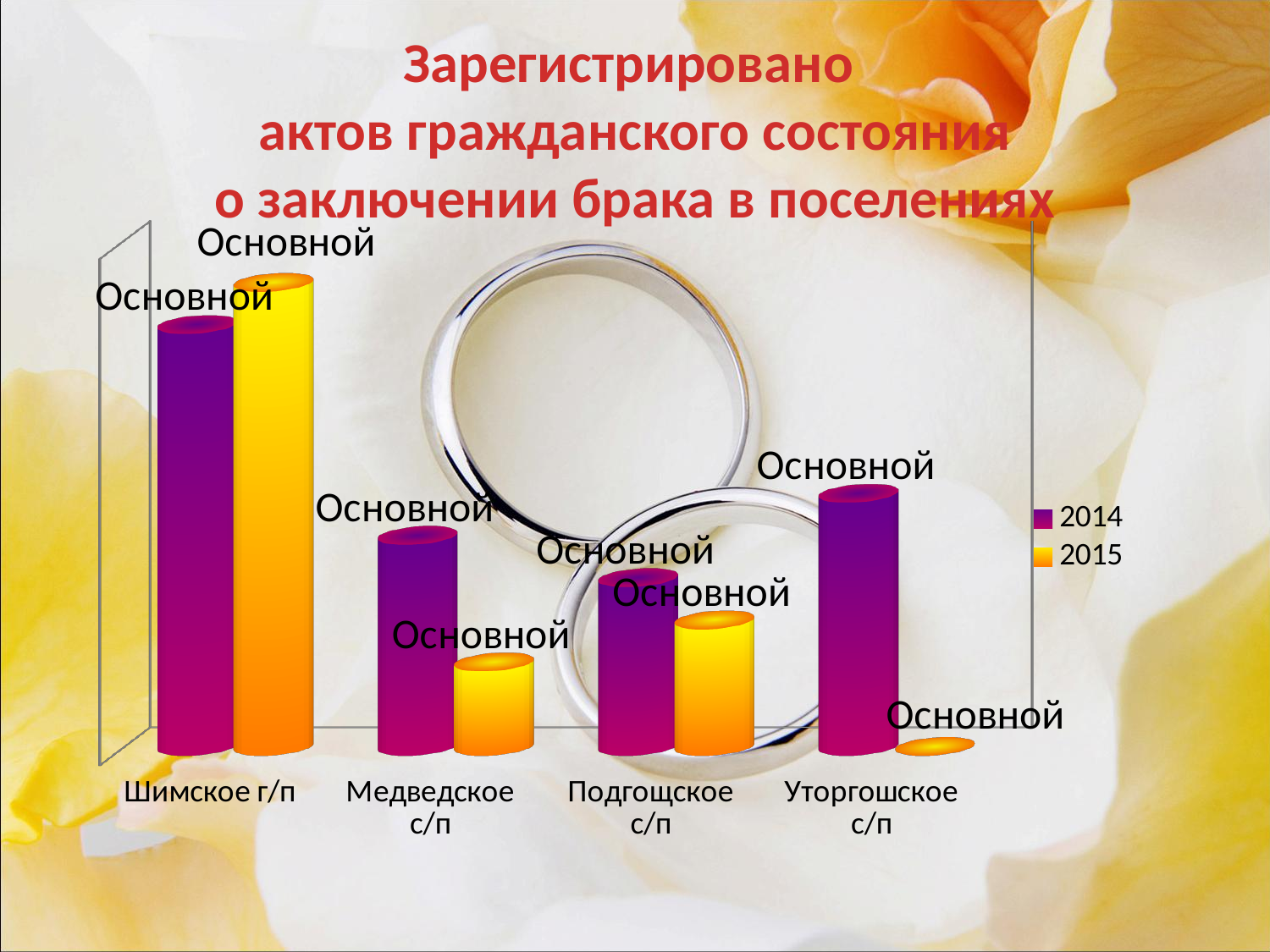
For Медведское с/п, which year has the larger value, 2014 or 2015? 2014 For Шимское г/п, which year has the larger value, 2014 or 2015? 2015 Which years are listed in the chart legend? 2014 and 2015 How many settlements (categories) are shown on the x axis of the chart? 4 Which is larger: the 2014 value for Уторгошское с/п or the 2014 value for Медведское с/п? Уторгошское с/п Which colour represents the 2015 series in the chart? yellow How many series does the chart legend list? 2 Which settlement has the highest value for 2014? Шимское г/п Which settlement has the highest value for 2015? Шимское г/п What kind of chart is shown on the slide? bar chart Which settlement has the lowest value for 2015? Уторгошское с/п